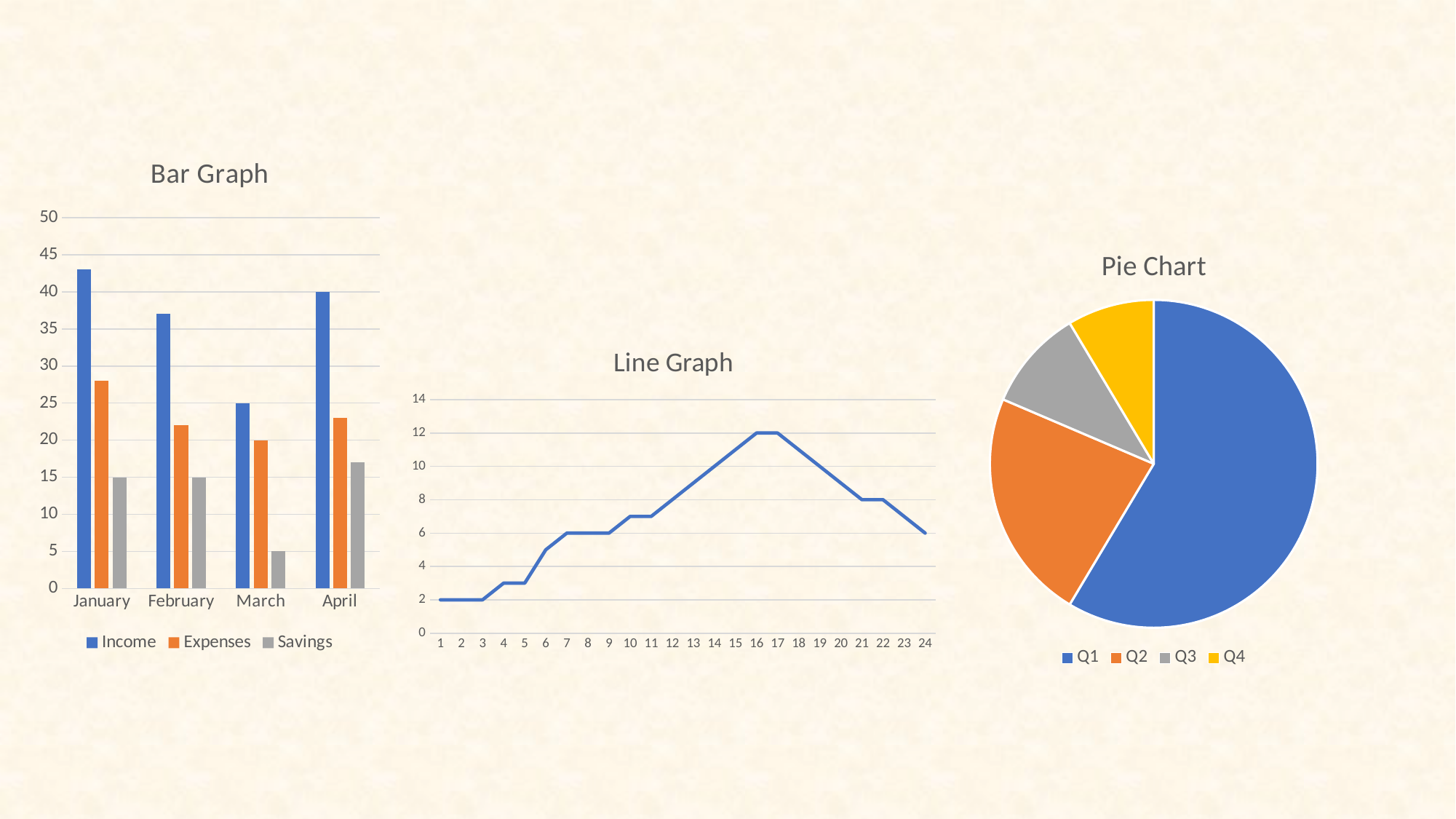
In the Bar Graph, which month has the lowest Savings bar? March In the Bar Graph, is the Expenses value for January greater or less than 25? greater In the Bar Graph, which month has the highest Income bar? January In the Line Graph, what is the value at point 16? 12 In the Line Graph, what is the value at point 1? 2 In the Pie Chart, which quarter has the largest slice? Q1 In the Line Graph, do the values rise or fall from point 17 to point 24? fall In the Bar Graph, is the Income value for March greater or less than 30? less What kind of chart is the chart titled "Bar Graph"? bar chart In the Bar Graph, how many months are shown on the x axis? 4 In the Bar Graph, which is larger for April: Income or Expenses? Income In the Bar Graph, how many series does the legend list? 3